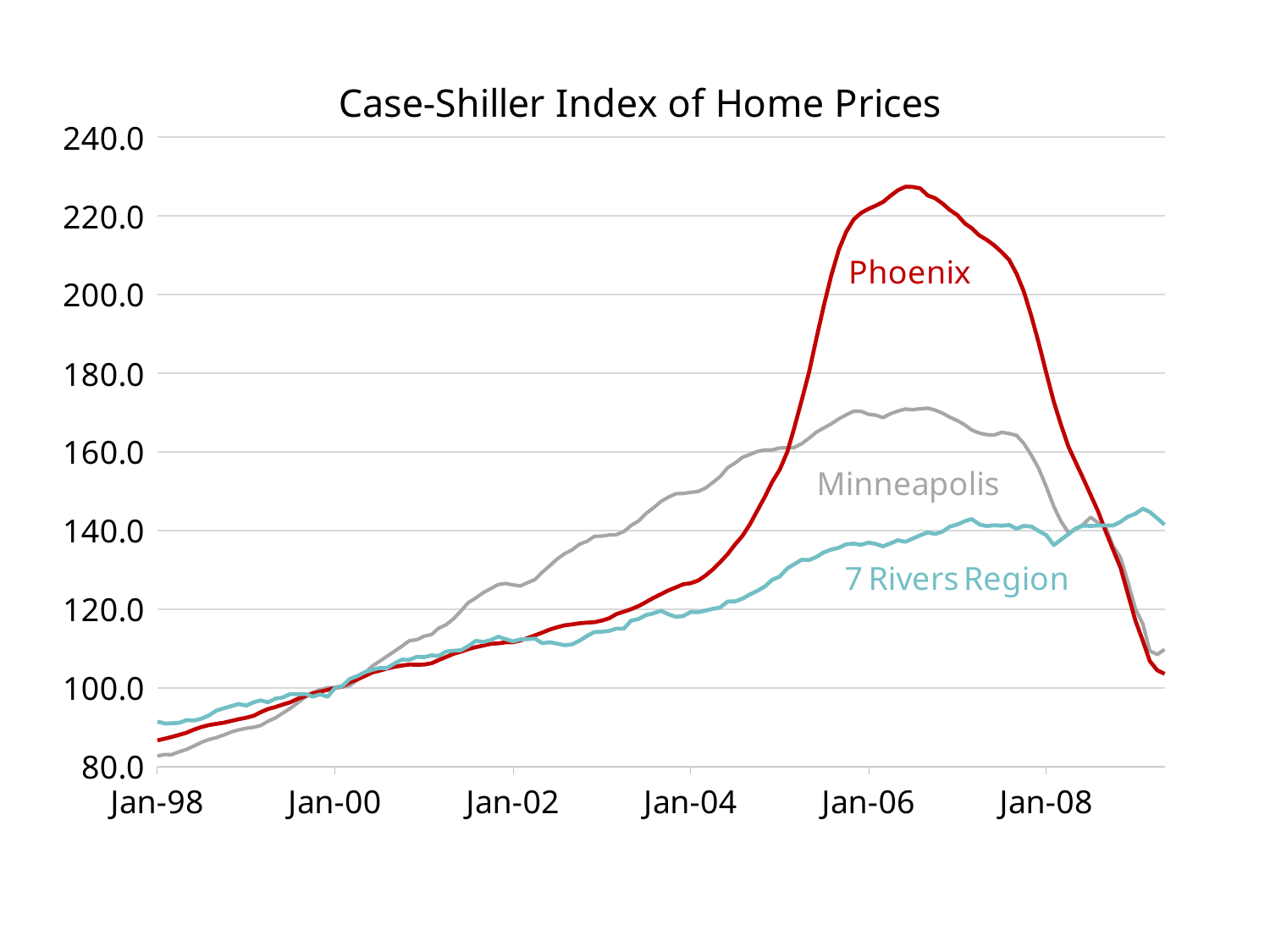
What kind of chart is shown on the slide? line chart Which series reaches the highest value on the chart? Phoenix How many series are plotted on the chart? 3 What is the title of the chart? Case-Shiller Index of Home Prices Is the value for Minneapolis at Jan-98 greater or less than 100? less At Jan-06, which is larger: Phoenix or Minneapolis? Phoenix Does the Phoenix line rise or fall between Jan-06 and the end of the chart? fall Which series has the lowest value at Jan-98? Minneapolis At Jan-04, which is larger: Minneapolis or Phoenix? Minneapolis Is the value for 7 Rivers Region at Jan-06 greater or less than 140? less Is the value for Phoenix at Jan-06 greater or less than 200? greater Which series is drawn in red? Phoenix